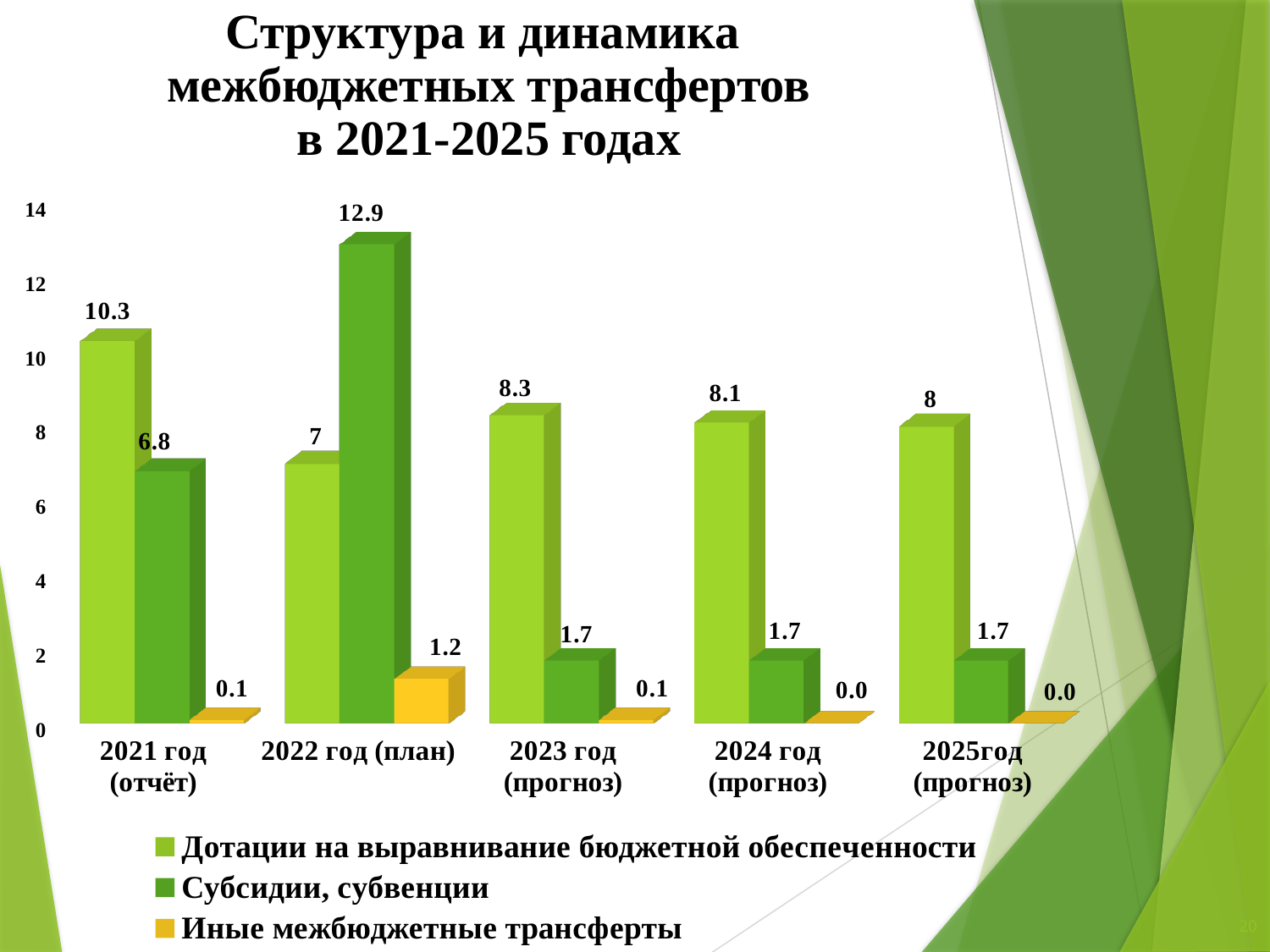
What is the total of the three series for 2023 год (прогноз)? 10.1 What is the value of Дотации на выравнивание бюджетной обеспеченности for 2021 год (отчёт)? 10.3 How many year categories are shown on the x axis? 5 How many series does the legend list? 3 What is the value of Дотации на выравнивание бюджетной обеспеченности for 2025год (прогноз)? 8 Which is larger in 2022 год (план): Дотации на выравнивание бюджетной обеспеченности or Субсидии, субвенции? Субсидии, субвенции What is the value of Иные межбюджетные трансферты for 2022 год (план)? 1.2 What is the value of Субсидии, субвенции for 2022 год (план)? 12.9 In which year is Субсидии, субвенции highest? 2022 год (план) In which year is Дотации на выравнивание бюджетной обеспеченности lowest? 2022 год (план) What kind of chart is shown on the slide? Bar chart What is the difference between Дотации на выравнивание бюджетной обеспеченности in 2021 год (отчёт) and in 2022 год (план)? 3.3